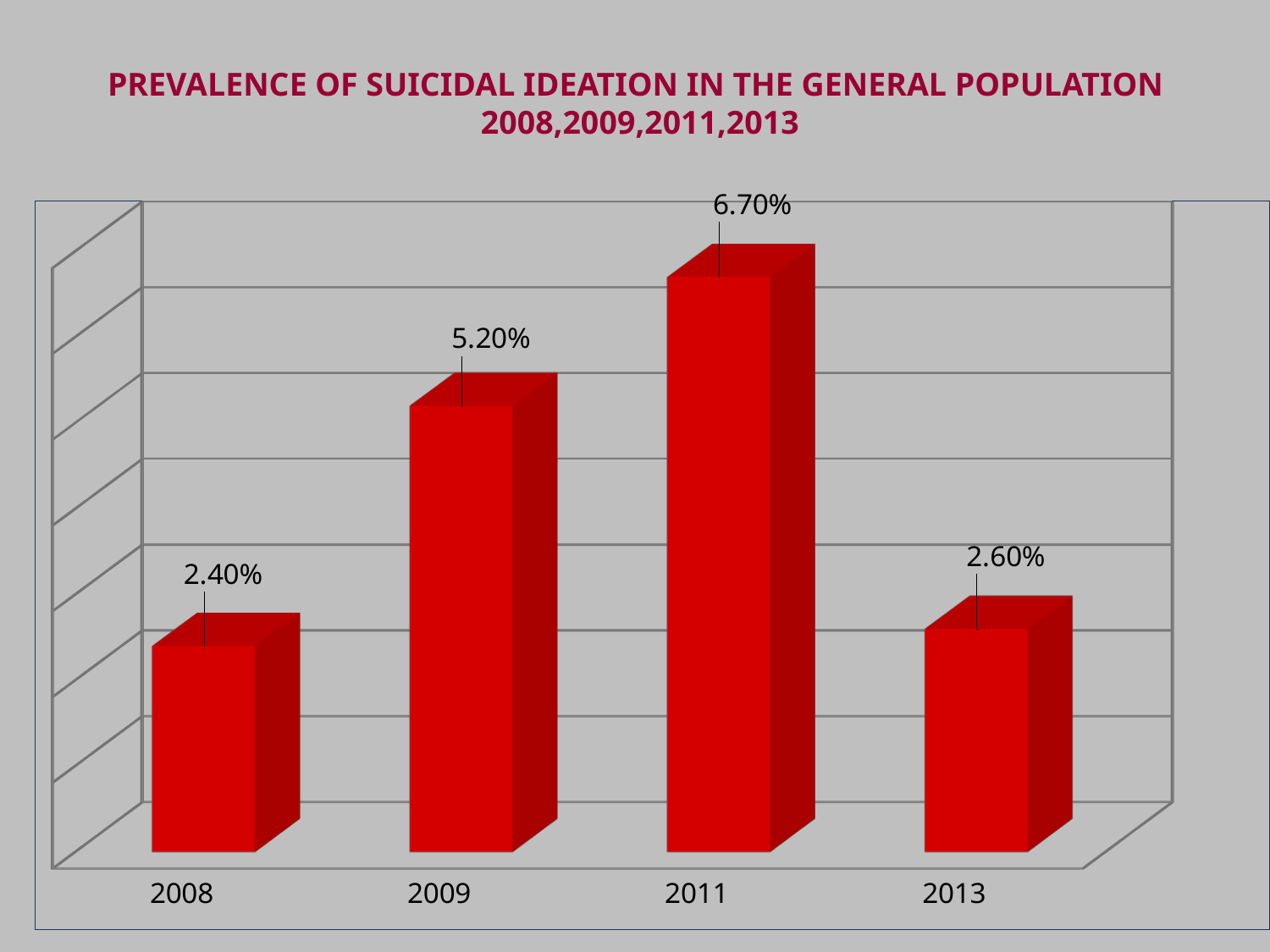
What is the title of the chart? Prevalence of Suicidal Ideation in the General Population 2008,2009,2011,2013 Which year has the highest prevalence of suicidal ideation? 2011 What is the difference between the prevalence in 2011 and in 2009? 1.50% What is the prevalence of suicidal ideation shown for 2008? 2.40% Which year has the lowest prevalence of suicidal ideation? 2008 What is the difference between the prevalence in 2013 and in 2008? 0.20% Which year has a higher prevalence, 2009 or 2013? 2009 What is the prevalence of suicidal ideation shown for 2011? 6.70% How many years are shown on the chart? 4 What is the prevalence of suicidal ideation shown for 2009? 5.20% What kind of chart is shown on the slide? Bar chart What is the prevalence of suicidal ideation shown for 2013? 2.60%